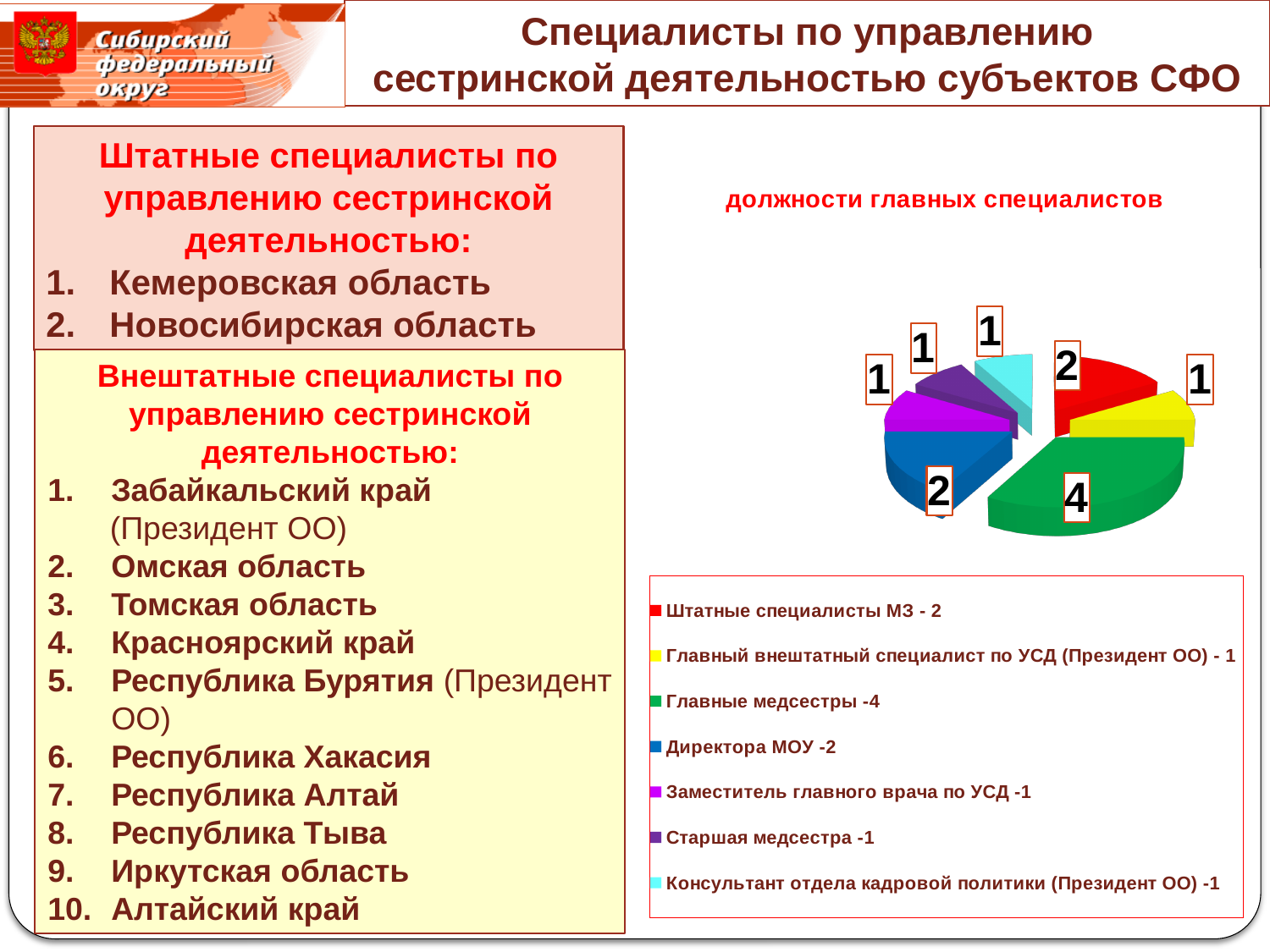
What is the difference between the values for Главные медсестры and Директора МОУ? 2 How many entries does the chart legend list? 7 How many slices does the pie chart have? 7 Which category has the largest slice of the pie? Главные медсестры What is the value for Директора МОУ? 2 What kind of chart is shown on the slide? pie chart What is the title of the chart? должности главных специалистов Which is larger: the value for Главные медсестры or the value for Штатные специалисты МЗ? Главные медсестры What is the value for Главные медсестры? 4 What colour is the slice for Главные медсестры? green What is the value for Штатные специалисты МЗ? 2 What is the value for Старшая медсестра? 1